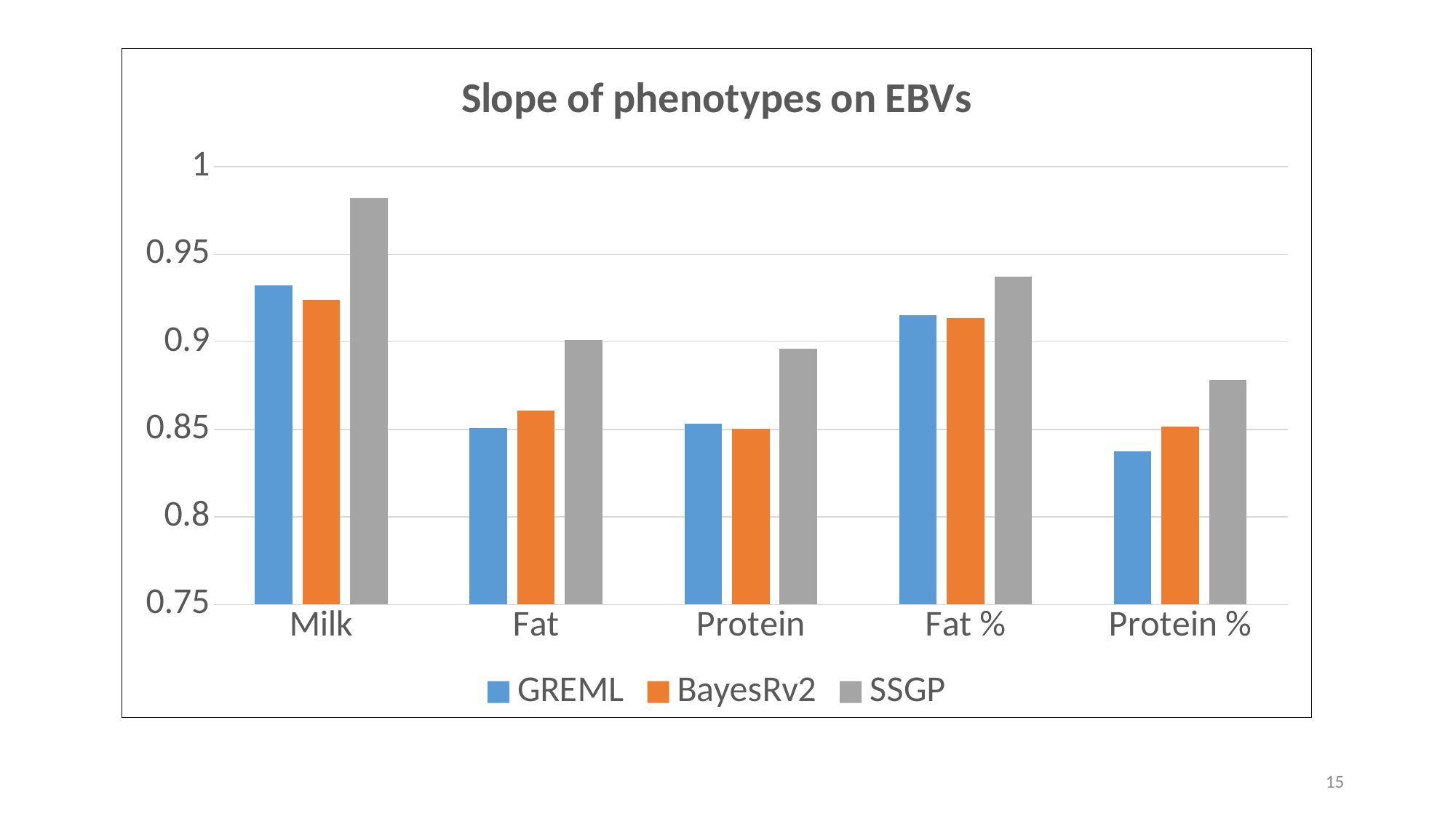
Which category has the lowest GREML value? Protein % What is the title of the chart? Slope of phenotypes on EBVs Is the SSGP value for Milk greater or less than 0.95? greater For Fat, which is larger: the SSGP value or the GREML value? SSGP What colour represents the BayesRv2 series in the legend? Orange Within the Milk category, which series has the highest bar? SSGP How many series does the legend list? 3 Is the GREML value for Protein % greater or less than 0.85? less Which category has the highest SSGP value? Milk Is the GREML value for Fat % greater or less than 0.9? greater How many categories are shown on the x axis? 5 What kind of chart is shown on the slide? Bar chart